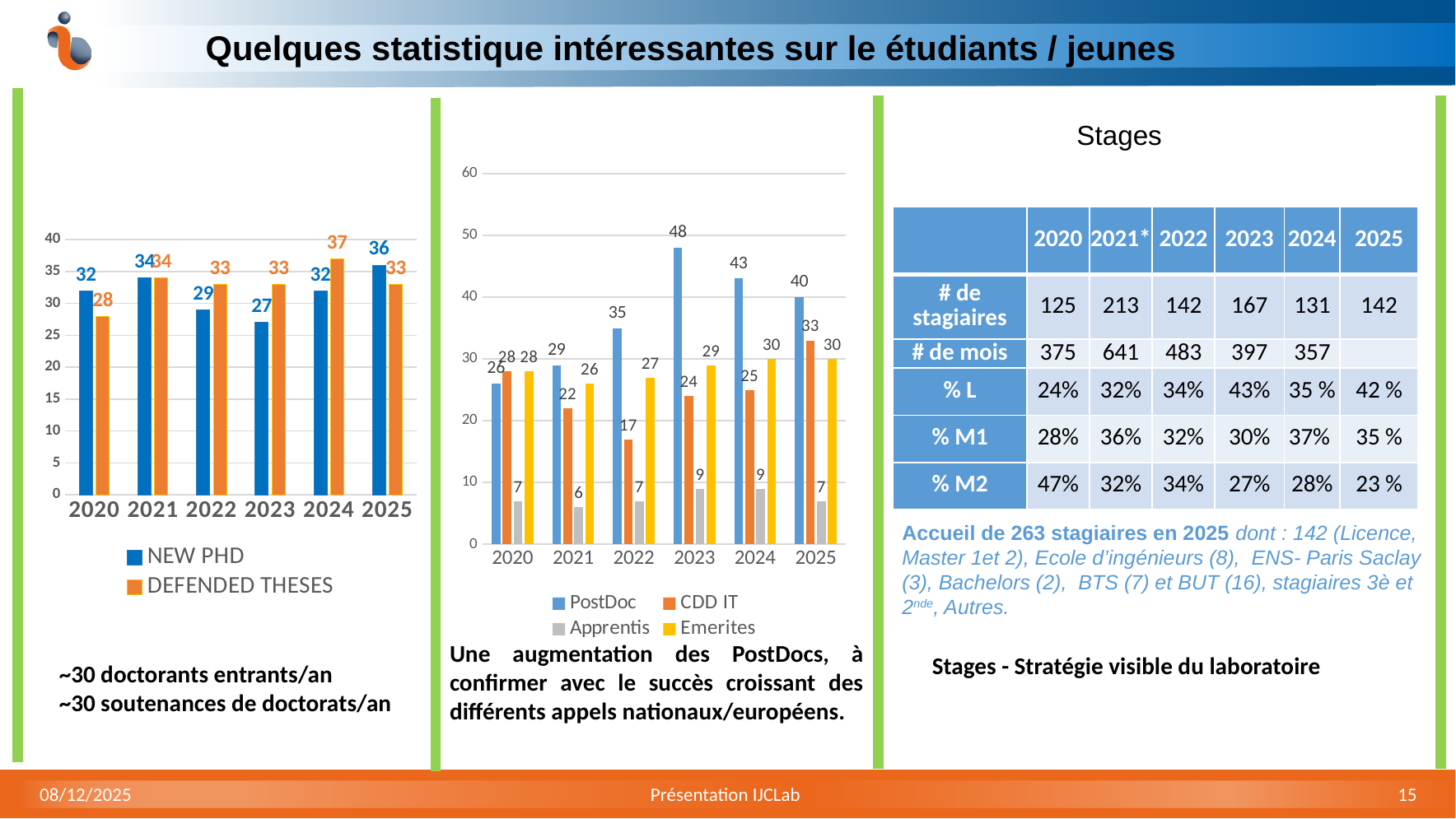
In the middle chart (PostDoc / CDD IT / Apprentis / Emerites), how many years are shown on the x axis? 6 In the middle chart (PostDoc / CDD IT / Apprentis / Emerites), what is the PostDoc value for 2023? 48 In the middle chart (PostDoc / CDD IT / Apprentis / Emerites), how many series does the legend list? 4 What kind of chart is the middle chart (PostDoc / CDD IT / Apprentis / Emerites)? Bar chart In the left chart (NEW PHD / DEFENDED THESES), what is the difference between DEFENDED THESES and NEW PHD in 2023? 6 In the left chart (NEW PHD / DEFENDED THESES), how many series does the legend list? 2 In the middle chart (PostDoc / CDD IT / Apprentis / Emerites), which is larger in 2025: PostDoc or CDD IT? PostDoc In the left chart (NEW PHD / DEFENDED THESES), which year has the lowest NEW PHD value? 2023 In the left chart (NEW PHD / DEFENDED THESES), what is the NEW PHD value for 2025? 36 In the left chart (NEW PHD / DEFENDED THESES), what is the DEFENDED THESES value for 2024? 37 In the middle chart (PostDoc / CDD IT / Apprentis / Emerites), which year has the lowest CDD IT value? 2022 In the middle chart (PostDoc / CDD IT / Apprentis / Emerites), what is the difference between the PostDoc values for 2023 and 2020? 22